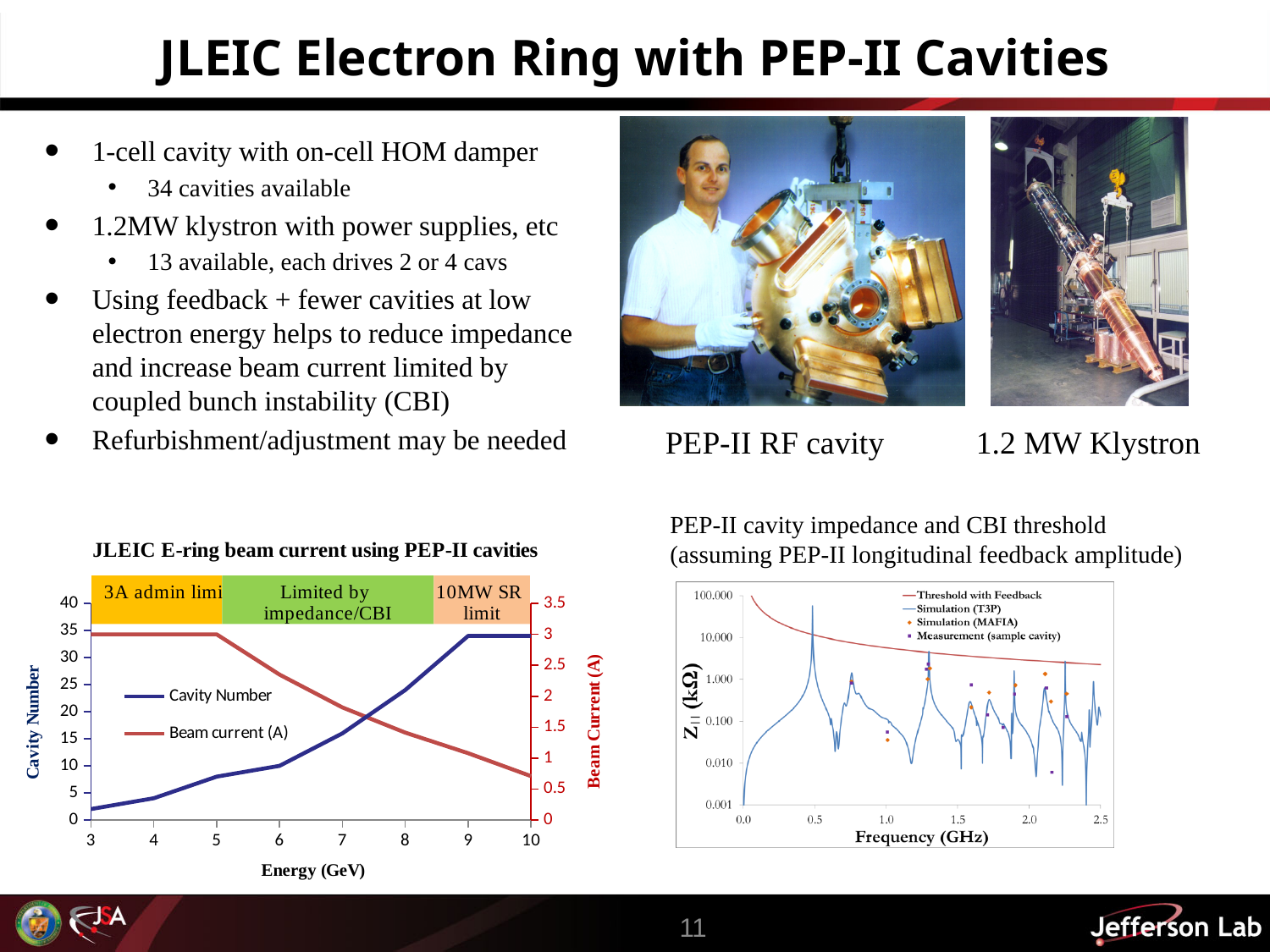
In the chart titled 'JLEIC E-ring beam current using PEP-II cavities', does the beam current rise or fall as energy increases from 5 to 10 GeV? fall In the chart titled 'JLEIC E-ring beam current using PEP-II cavities', is the Cavity Number at 8 GeV greater or less than 20? greater In the chart titled 'PEP-II cavity impedance and CBI threshold', is the 'Threshold with Feedback' value at 2.0 GHz greater or less than 1.000? greater In the chart titled 'JLEIC E-ring beam current using PEP-II cavities', what kind of chart is it? line chart In the chart titled 'PEP-II cavity impedance and CBI threshold', does the 'Threshold with Feedback' curve rise or fall as frequency increases? fall In the chart titled 'JLEIC E-ring beam current using PEP-II cavities', how many series does the legend list? 2 In the chart titled 'JLEIC E-ring beam current using PEP-II cavities', what are the two legend entries? Cavity Number and Beam current (A) In the chart titled 'JLEIC E-ring beam current using PEP-II cavities', what is the x-axis title? Energy (GeV) In the chart titled 'JLEIC E-ring beam current using PEP-II cavities', what is the beam current at 4 GeV? 3 In the chart titled 'JLEIC E-ring beam current using PEP-II cavities', does the Cavity Number rise or fall as energy increases from 3 to 9 GeV? rise In the chart titled 'PEP-II cavity impedance and CBI threshold', how many series does the legend list? 4